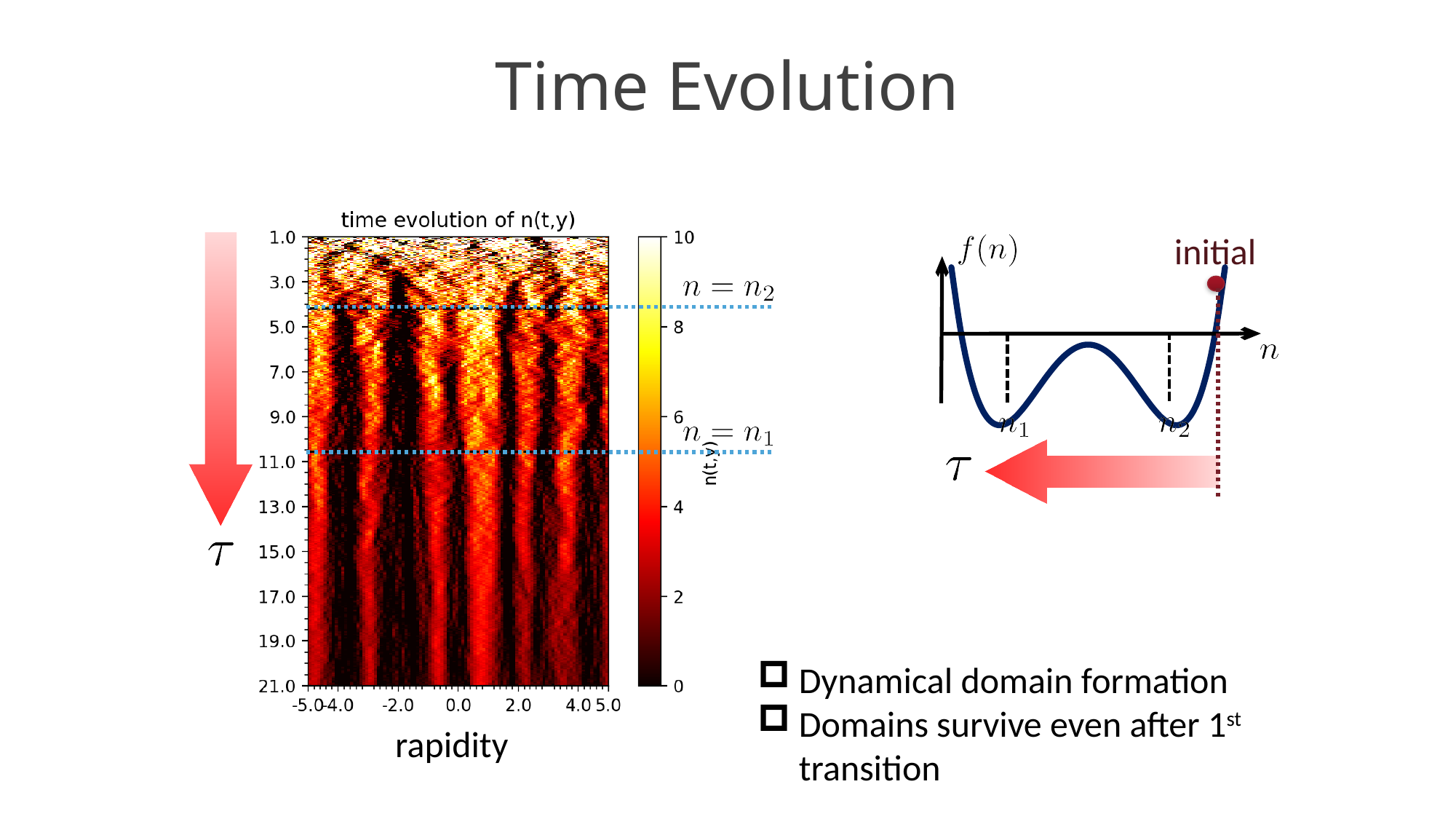
What kind of chart is the left chart titled 'time evolution of n(t,y)'? heatmap On the left chart, what is the lowest value shown on the colour bar? 0 On the left chart, which dotted line appears at an earlier τ (higher on the plot): n = n1 or n = n2? n = n2 On the left chart, what is the rightmost rapidity tick value on the x axis? 5.0 On the right chart of f(n) versus n, how many minima are marked with dashed lines? 2 On the left chart, what is the leftmost rapidity tick value on the x axis? -5.0 On the left chart, what is the highest value shown on the colour bar? 10 On the left chart, what is the largest τ value shown on the vertical axis? 21.0 On the left chart, how many horizontal dotted lines are drawn across the heatmap? 2 What is the title of the left chart? time evolution of n(t,y) What is the x-axis label of the left chart? rapidity On the left chart, what is the smallest τ value shown on the vertical axis? 1.0